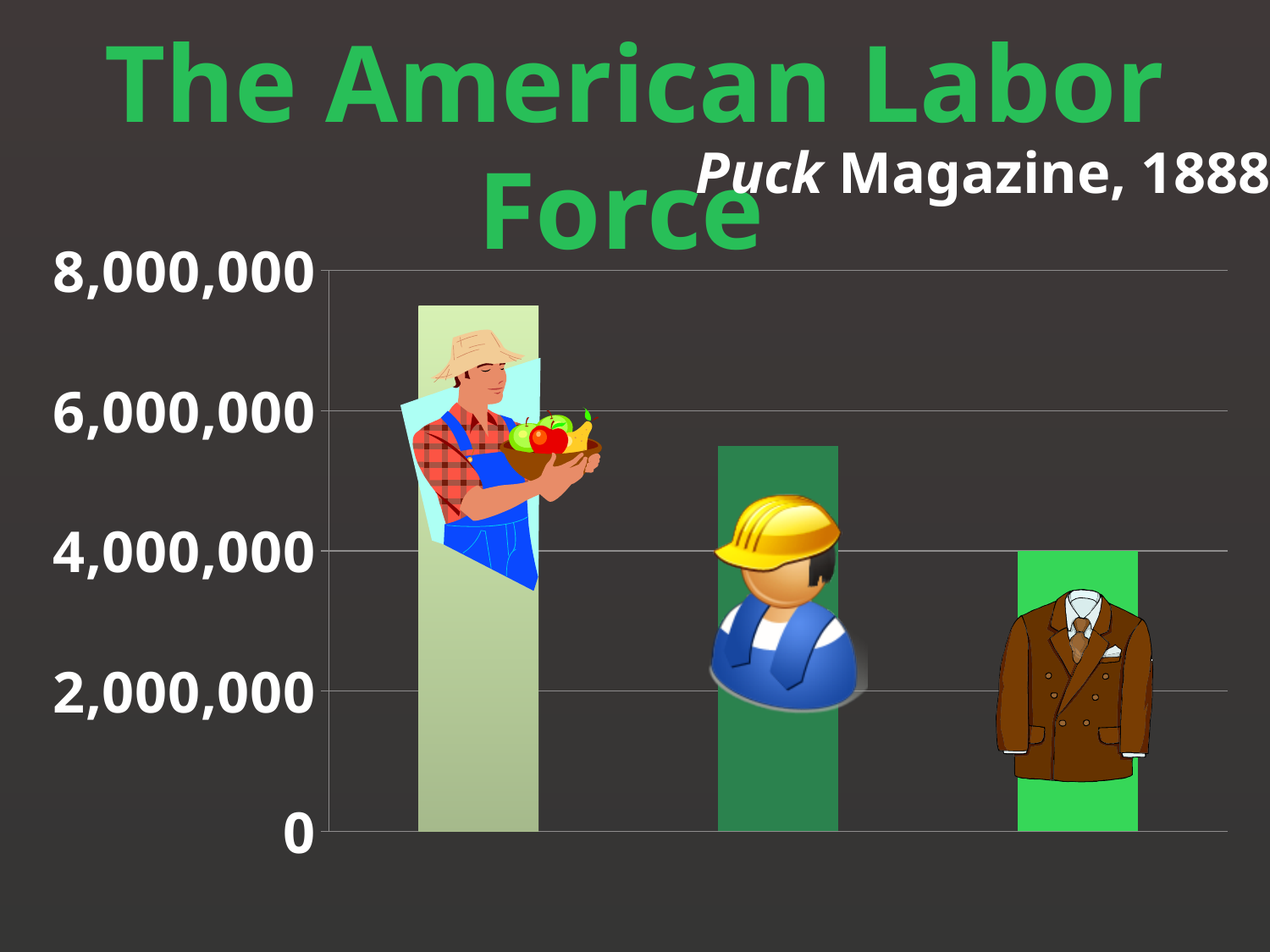
What is the highest value labeled on the vertical axis? 8,000,000 Is the value of the leftmost bar (farmer) greater or less than 6,000,000? greater What kind of chart is shown on the slide? bar chart Do the bar values rise or fall from left to right across the chart? fall Which is larger, the leftmost bar (farmer) or the middle bar (construction worker)? the leftmost bar (farmer) Is the value of the middle bar (construction worker) greater or less than 4,000,000? greater What is the title of the chart on the slide? The American Labor Force Which bar is the highest: the left (farmer), middle (construction worker), or right (suit)? the left bar (farmer) Is the value of the rightmost bar (suit) greater or less than 6,000,000? less Which bar is the lowest: the left (farmer), middle (construction worker), or right (suit)? the right bar (suit) How many bars does the chart show? 3